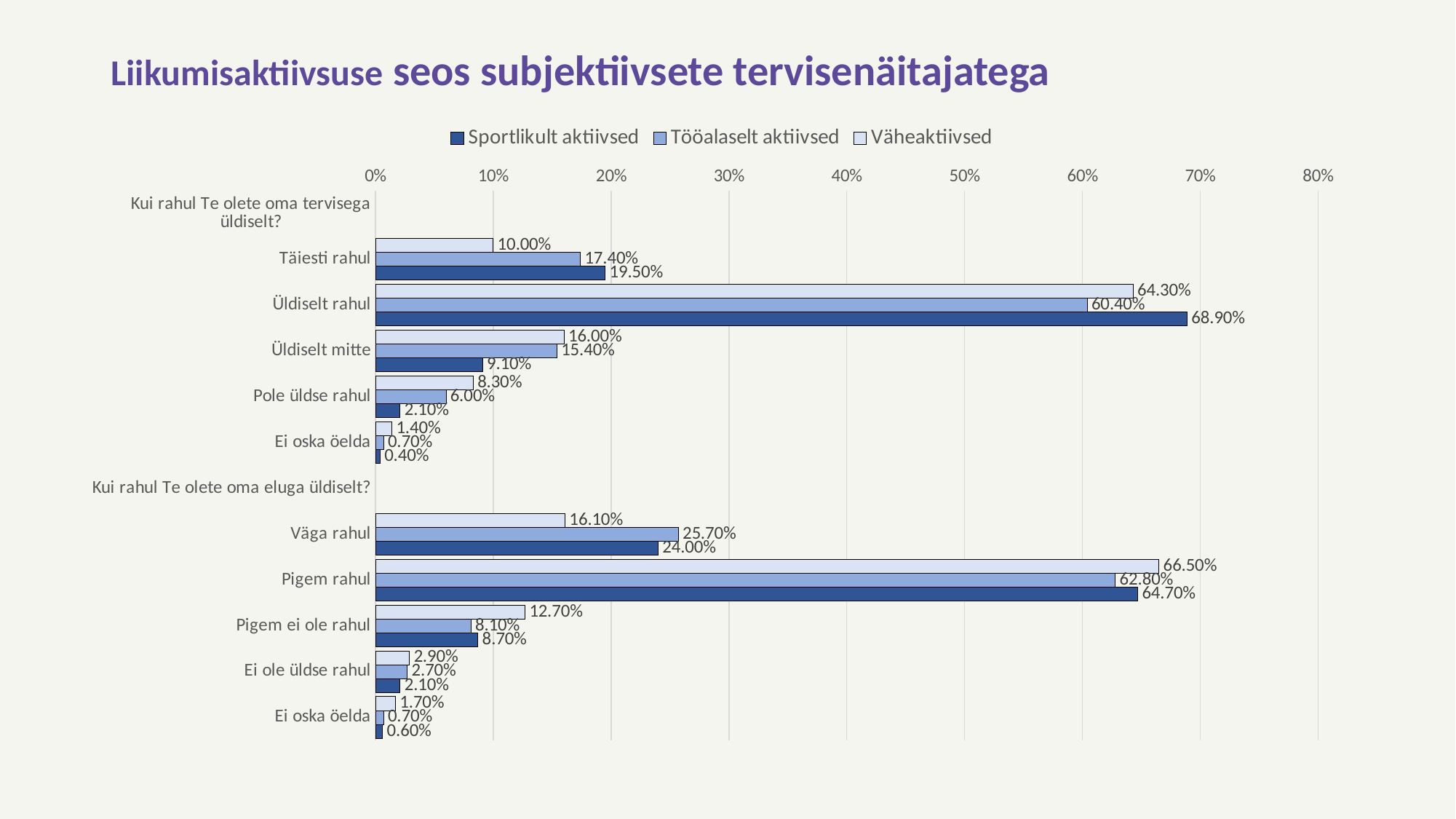
What is the value for Sportlikult aktiivsed in the Pole üldse rahul category? 2.10% What is the value for Sportlikult aktiivsed in the Üldiselt rahul category? 68.90% Which series has the lowest value in the Täiesti rahul category? Väheaktiivsed Is the value for Sportlikult aktiivsed in the Pigem rahul category greater or less than 60%? greater What is the difference between the Sportlikult aktiivsed and Tööalaselt aktiivsed values in the Üldiselt rahul category? 8.50% What is the value for Tööalaselt aktiivsed in the Väga rahul category? 25.70% What is the value for Väheaktiivsed in the Pigem rahul category? 66.50% How many series does the legend list? 3 Which series has the highest value in the Üldiselt mitte category? Väheaktiivsed Which series is shown in the darkest blue colour in the legend? Sportlikult aktiivsed Which is larger in the Pigem ei ole rahul category: Väheaktiivsed or Sportlikult aktiivsed? Väheaktiivsed What kind of chart is shown on the slide? bar chart